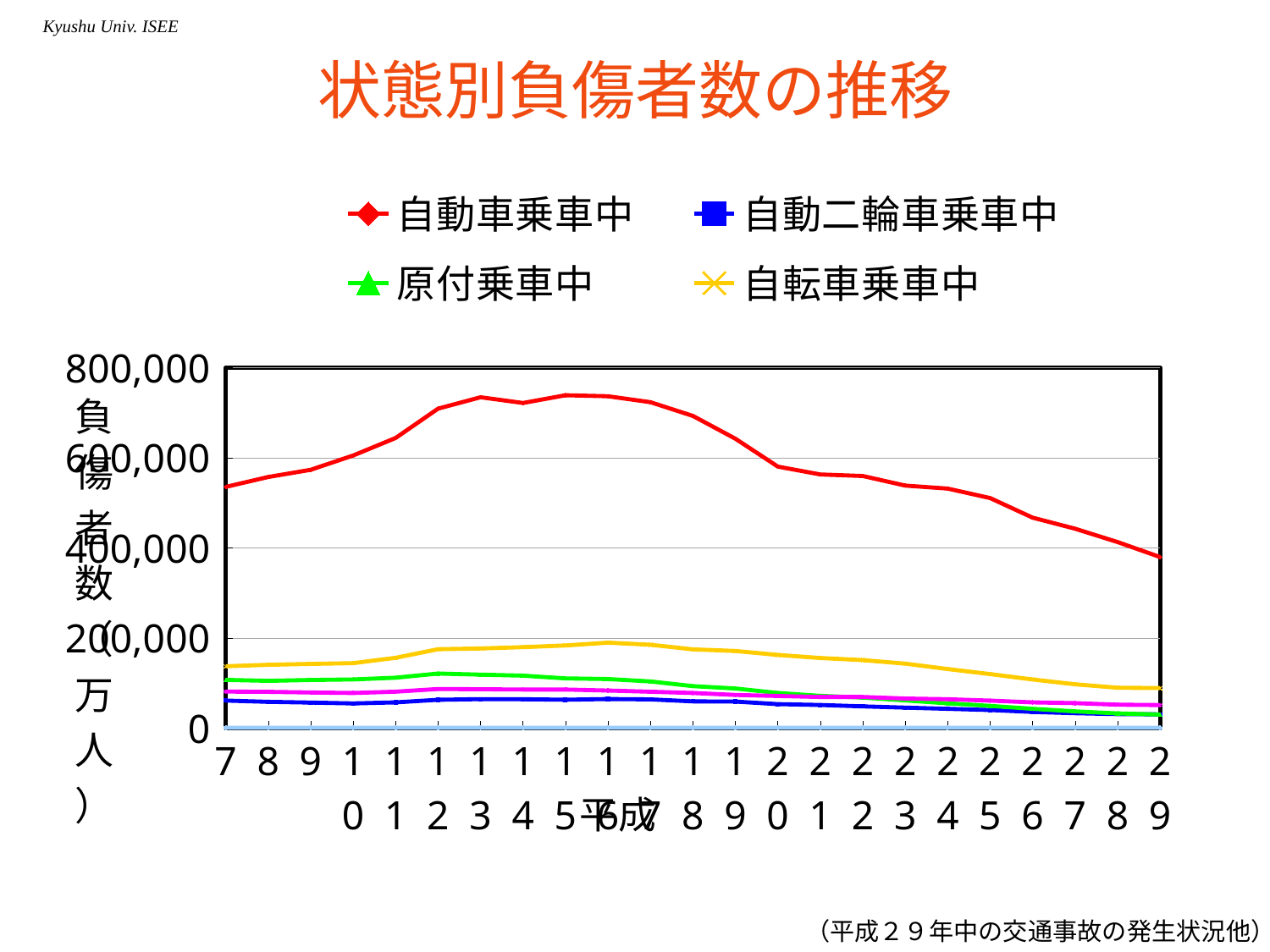
Which is larger in 平成12, 原付乗車中 or 自動二輪車乗車中? 原付乗車中 What is the title of the chart? 状態別負傷者数の推移 Which series has the highest values throughout the chart? 自動車乗車中 Does the value for 自動車乗車中 rise or fall from 平成16 to 平成29? fall Is the value for 自動車乗車中 in 平成16 greater or less than 600,000? greater Is the value for 自動車乗車中 in 平成29 greater or less than 600,000? less How many series does the legend list? 4 Is the value for 自転車乗車中 in 平成16 greater or less than 100,000? greater How many years (points) are shown along the x axis? 23 What colour is the line for 自動車乗車中? red What kind of chart is shown on the slide? line chart